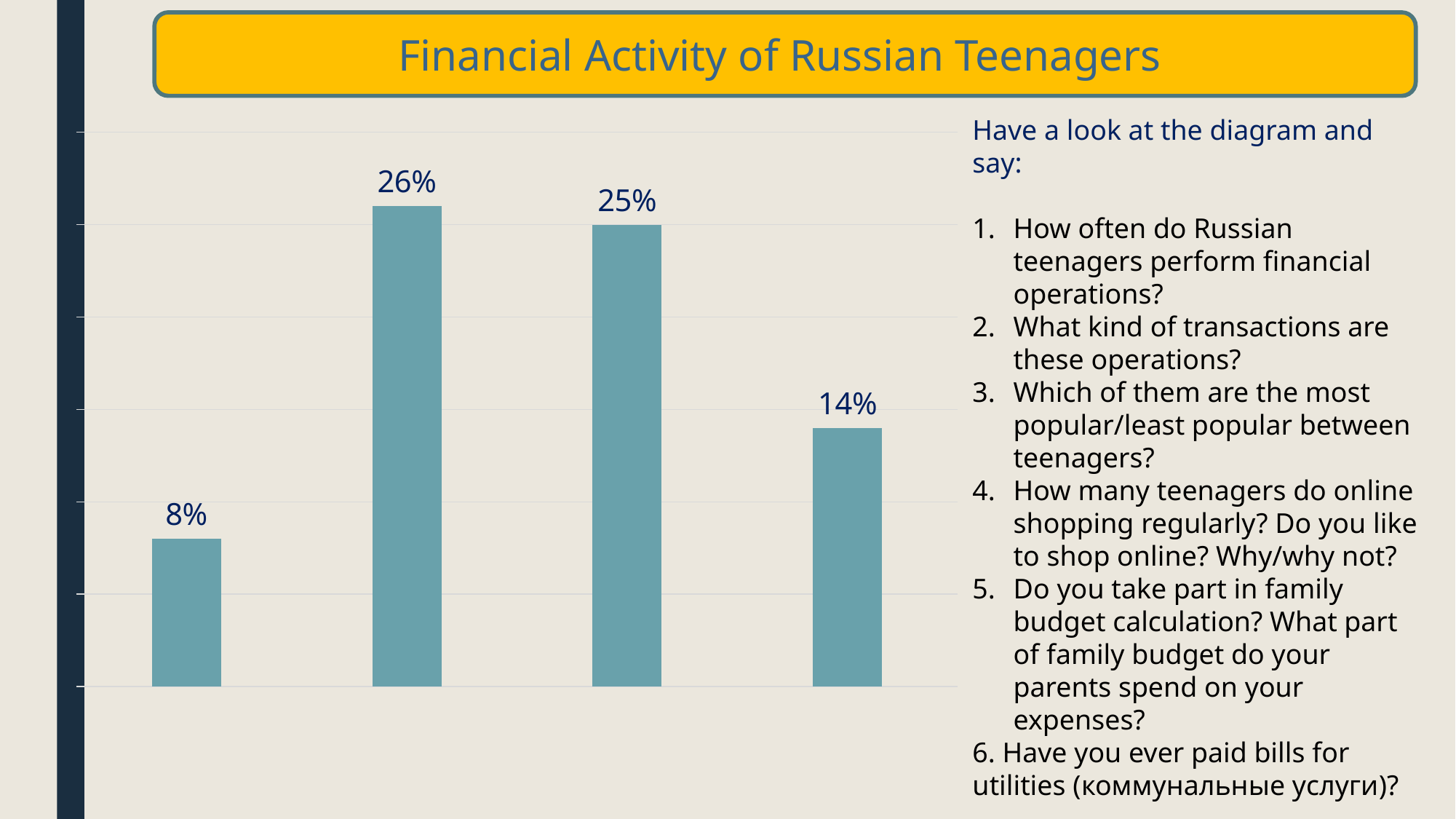
How many bars are plotted in the chart? 4 What kind of chart is shown on the slide? Bar chart What value is shown on the third bar from the left? 25% What is the difference between the third bar (25%) and the fourth bar (14%)? 11 percentage points Which bar has the highest value? The second bar from the left (26%) What value is shown on the fourth bar from the left? 14% Which is larger, the value of the second bar or the value of the third bar? The second bar (26%) What value is shown on the first bar from the left? 8% What is the title shown at the top of the slide above the chart? Financial Activity of Russian Teenagers Which bar has the lowest value? The first bar from the left (8%) What value is shown on the second bar from the left? 26% What is the difference between the highest and lowest bar values? 18 percentage points